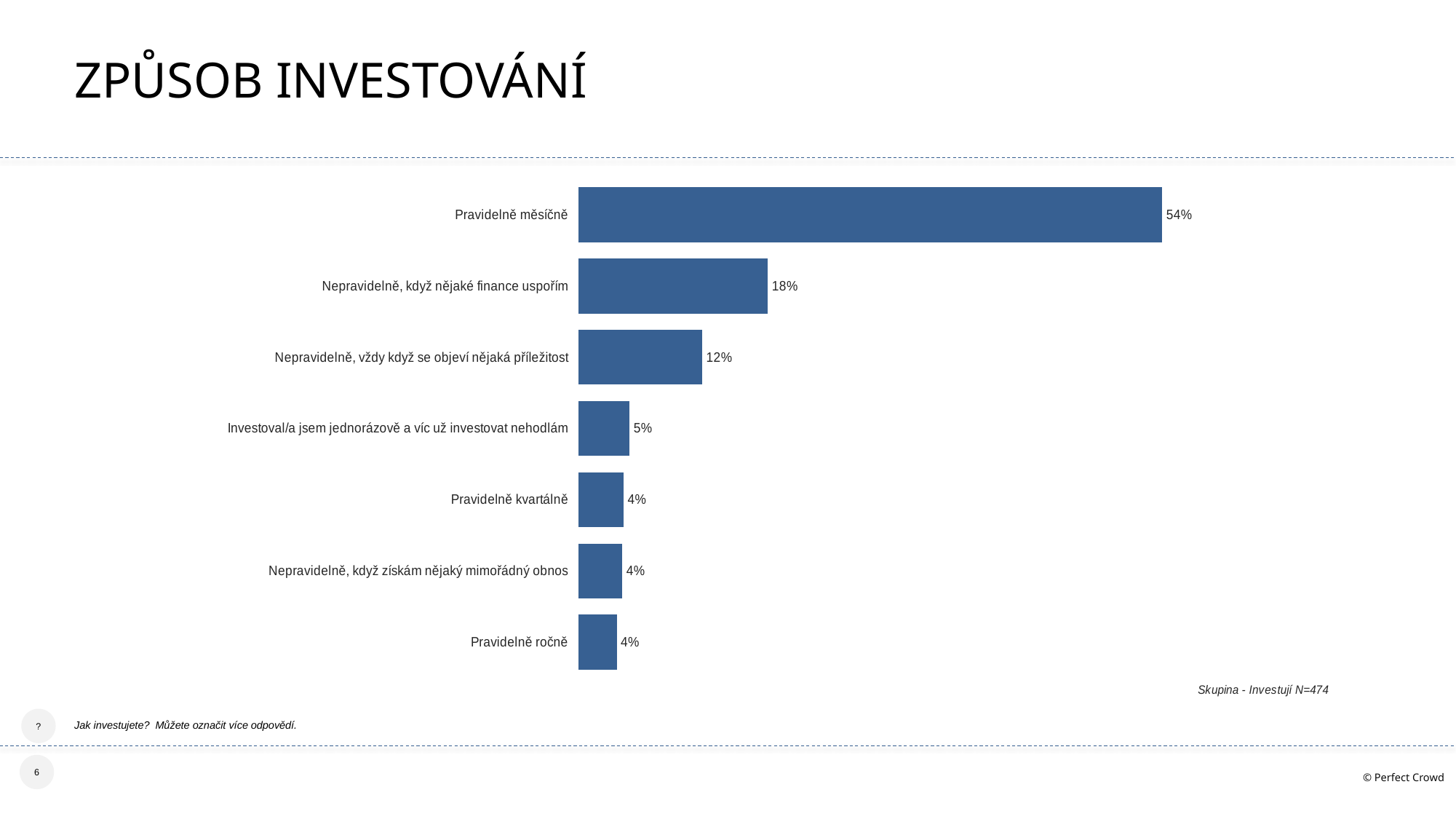
What is the value for "Nepravidelně, vždy když se objeví nějaká příležitost"? 12% What is the value for "Pravidelně kvartálně"? 4% What is the value for "Nepravidelně, když nějaké finance uspořím"? 18% What is the value for "Pravidelně měsíčně"? 54% What kind of chart is shown on the slide? Bar chart What is the value for "Investoval/a jsem jednorázově a víc už investovat nehodlám"? 5% Which is larger, the value for "Nepravidelně, vždy když se objeví nějaká příležitost" or the value for "Investoval/a jsem jednorázově a víc už investovat nehodlám"? Nepravidelně, vždy když se objeví nějaká příležitost Which category has the highest value? Pravidelně měsíčně What is the difference between the values for "Nepravidelně, když nějaké finance uspořím" and "Nepravidelně, vždy když se objeví nějaká příležitost"? 6 percentage points What is the difference between the values for "Pravidelně měsíčně" and "Nepravidelně, když nějaké finance uspořím"? 36 percentage points What is the title of the slide containing the chart? ZPŮSOB INVESTOVÁNÍ How many categories are shown in the chart? 7